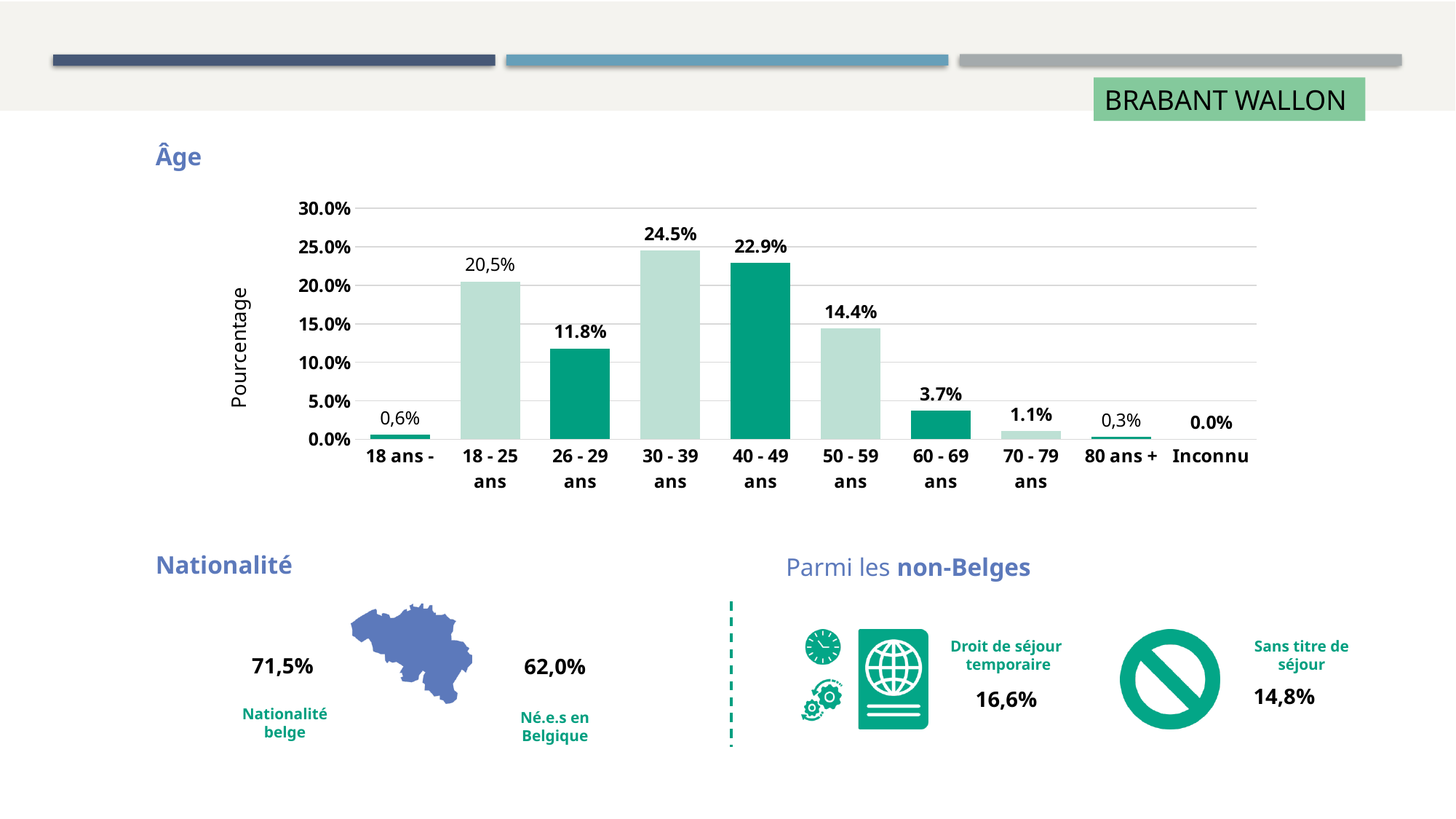
How many age categories are shown on the x axis of the Âge chart? 10 In the Âge chart, is the value for 50 - 59 ans greater or less than 10.0%? greater In the Âge chart, which is larger: the value for 18 - 25 ans or the value for 26 - 29 ans? 18 - 25 ans What type of chart is shown under the heading "Âge"? bar chart In the Âge chart, what is the difference between the values for 30 - 39 ans and 40 - 49 ans? 1.6% In the Âge chart, which category has the lowest value? Inconnu In the Âge chart, what is the value for 60 - 69 ans? 3.7% In the Âge chart, what is the value for 30 - 39 ans? 24.5% In the Âge chart, what is the value for 80 ans +? 0,3% In the Âge chart, which age category has the highest value? 30 - 39 ans In the Âge chart, what is the value for 18 - 25 ans? 20,5% What is the label of the vertical axis of the Âge chart? Pourcentage